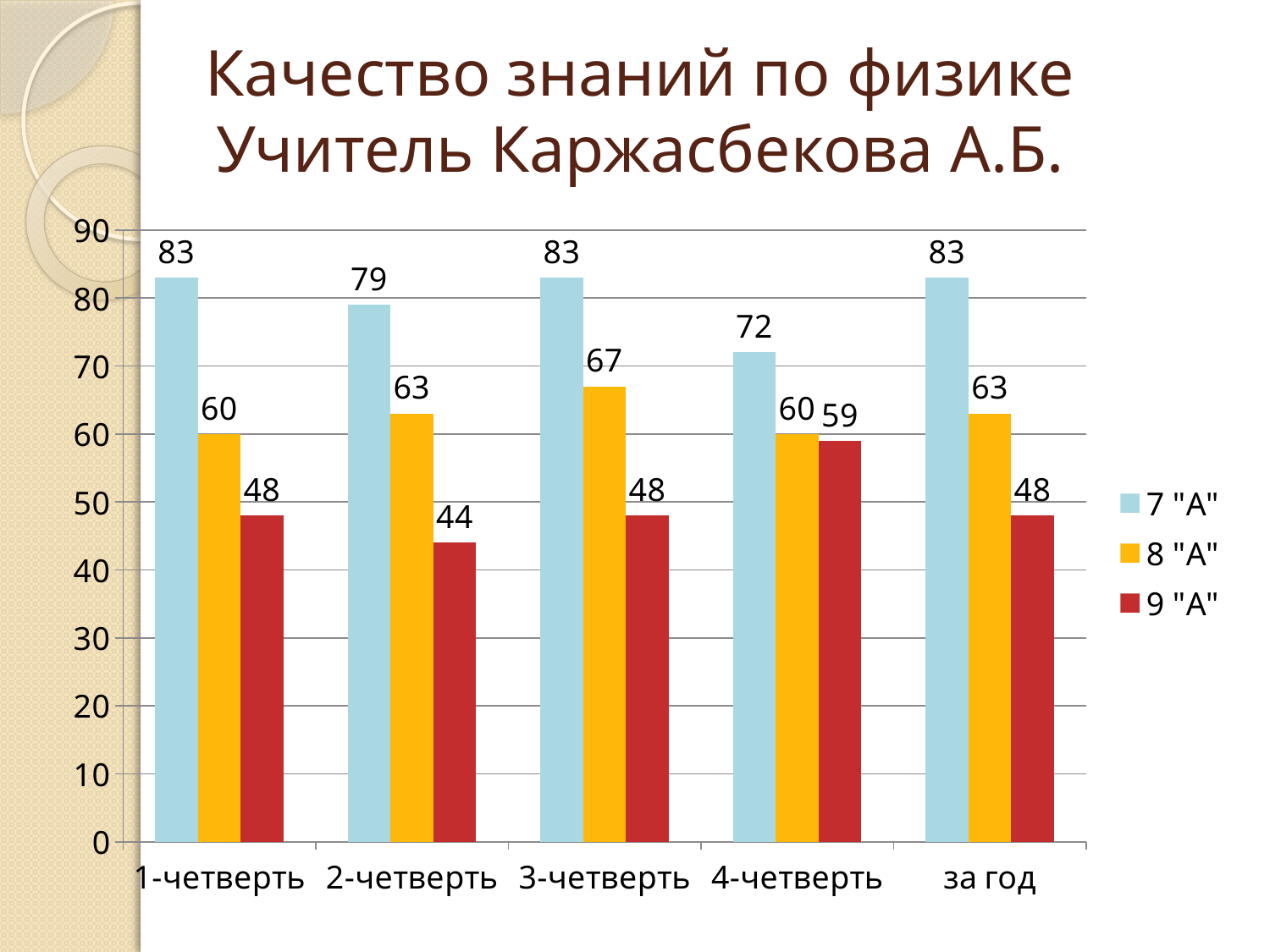
Which category has the highest value for 8 "А"? 3-четверть What is the value for 9 "А" in 4-четверть? 59 How many series does the legend list? 3 What is the value for 7 "А" in 2-четверть? 79 How many categories are shown on the x axis? 5 Which category has the lowest value for 9 "А"? 2-четверть What is the value for 8 "А" for за год? 63 What is the difference between the 7 "А" and 9 "А" values in 1-четверть? 35 What is the value for 8 "А" in 3-четверть? 67 Which is larger in 4-четверть: the value for 8 "А" or 9 "А"? 8 "А" Which series is shown in red in the legend? 9 "А" What kind of chart is shown on the slide? bar chart